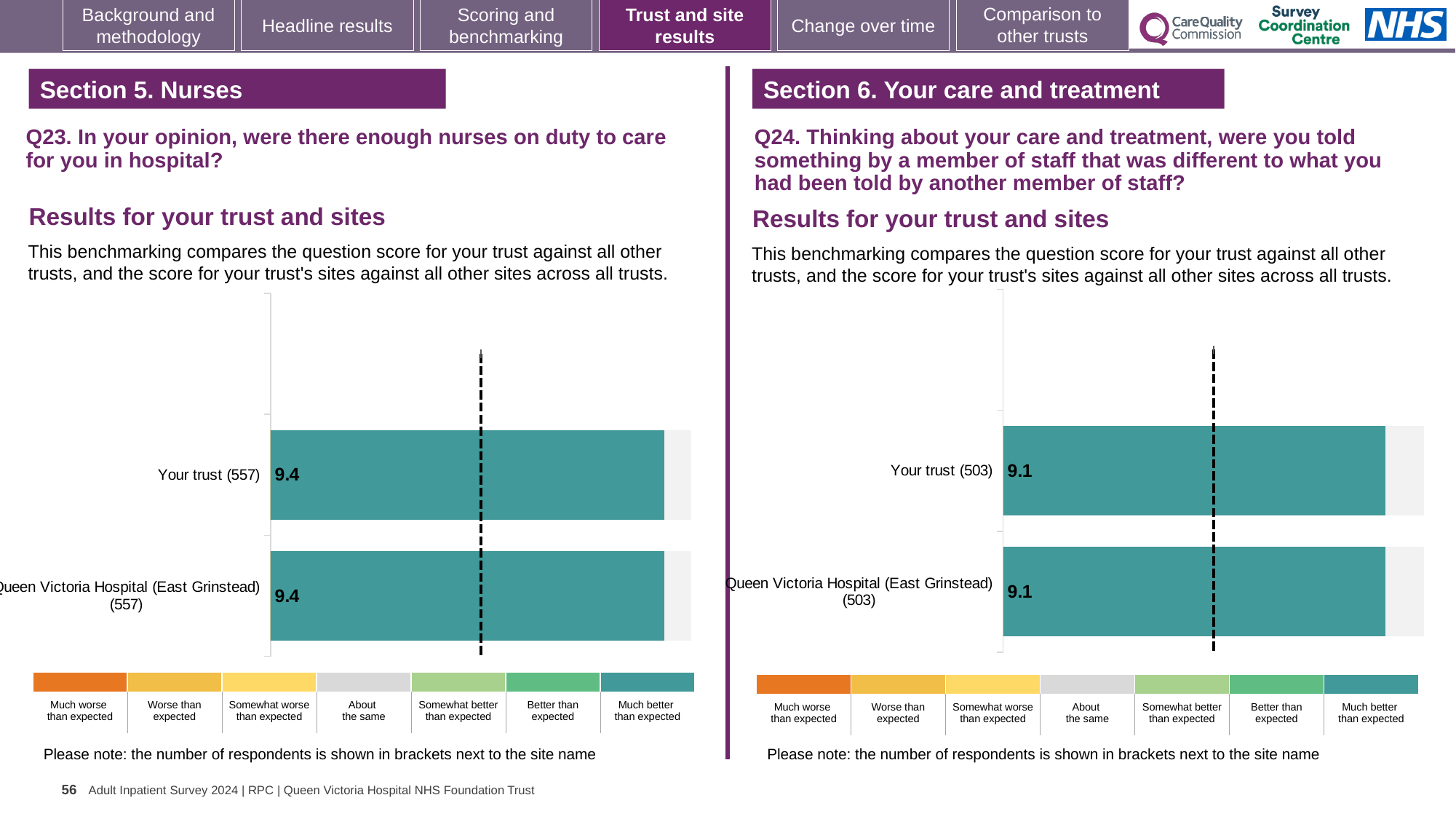
In the Q23 chart on the left, what is the score for Queen Victoria Hospital (East Grinstead) (557)? 9.4 How many bars are plotted in the Q23 chart on the left? 2 According to the colour key below the Q23 chart on the left, which category does the teal colour of the bars represent? Much better than expected In the Q23 chart on the left, what is the difference between the score for Your trust and the score for Queen Victoria Hospital (East Grinstead)? 0.0 In the Q23 chart on the left, what is the score for Your trust (557)? 9.4 In the Q24 chart on the right, what is the difference between the score for Your trust and the score for Queen Victoria Hospital (East Grinstead)? 0.0 What kind of chart is used for the Q23 results on the left? Bar chart In the Q24 chart on the right, what is the score for Your trust (503)? 9.1 How many respondents are shown in brackets for Your trust in the Q24 chart on the right? 503 In the Q24 chart on the right, what is the score for Queen Victoria Hospital (East Grinstead) (503)? 9.1 Is the score for Your trust in the Q23 chart on the left larger than the score for Your trust in the Q24 chart on the right? Yes How many bars are plotted in the Q24 chart on the right? 2